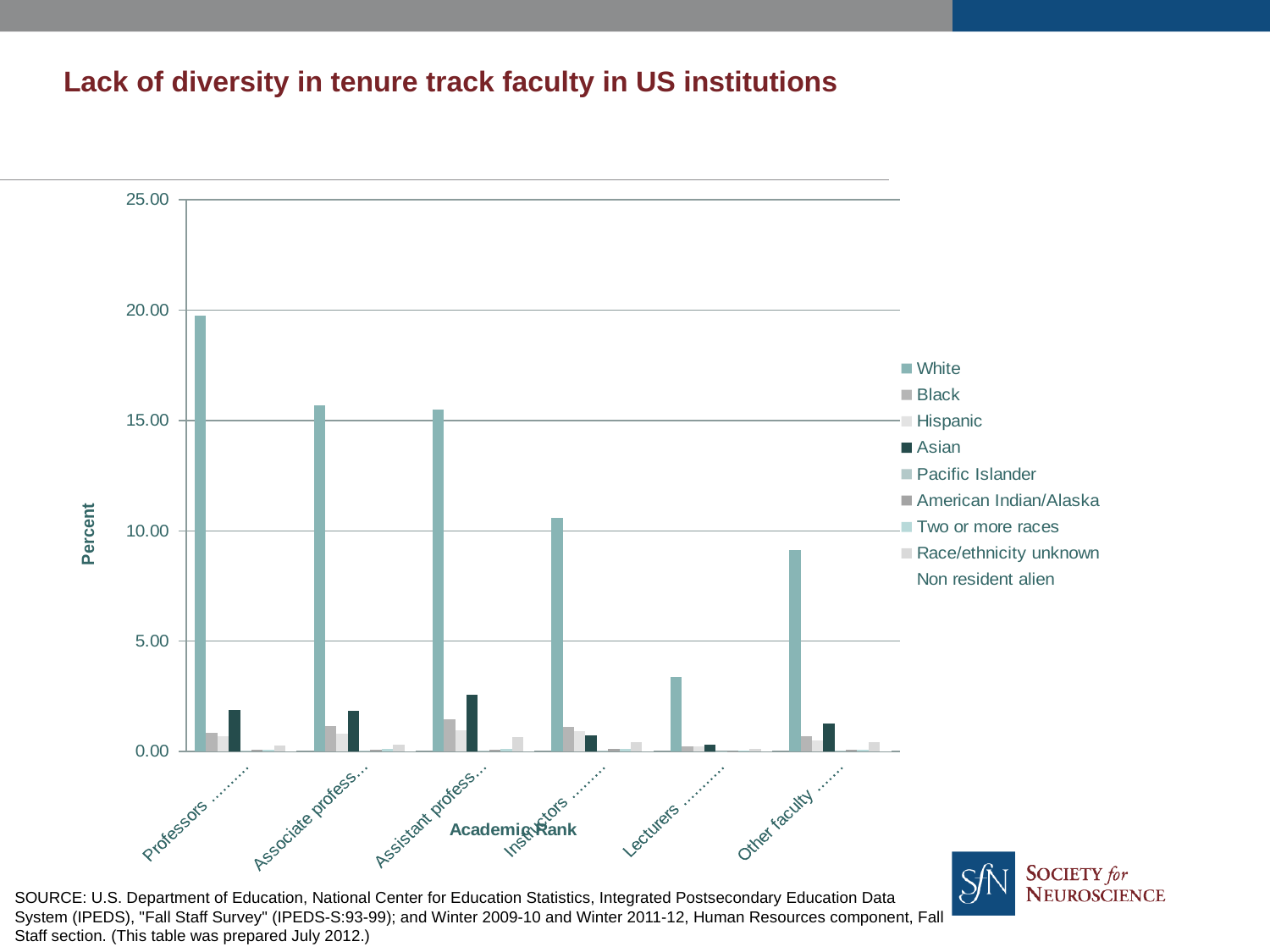
How many academic rank categories are shown on the x axis? 6 Which academic rank has the highest value for White? Professors What is the label of the y axis? Percent Is the value for White among Professors greater or less than 15? greater What is the title of the slide? Lack of diversity in tenure track faculty in US institutions Is the value for White among Instructors greater or less than 15? less What kind of chart is shown on the slide? bar chart Which academic rank has the lowest value for White? Lecturers Is the value for White among Other faculty greater or less than 10? less Which is larger: the White value for Professors or the White value for Lecturers? Professors How many series does the legend list? 9